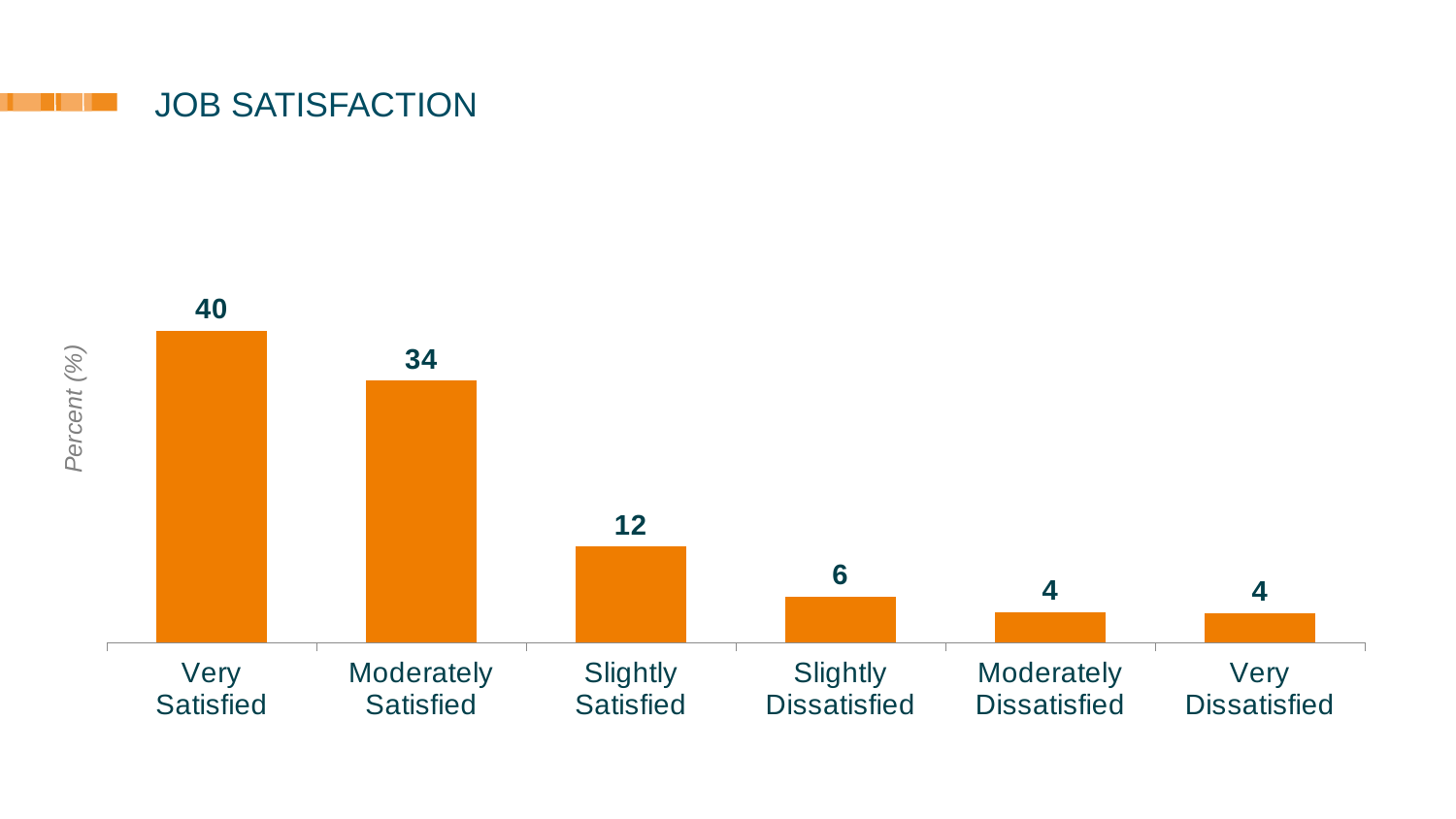
Do the values rise or fall from left to right along the x axis? Fall What is the value for Slightly Dissatisfied? 6 What kind of chart is shown on the slide? Bar chart What is the difference between the values for Slightly Satisfied and Slightly Dissatisfied? 6 How many categories are shown on the x axis? 6 What is the title of the chart? JOB SATISFACTION Which is larger, the value for Slightly Satisfied or the value for Moderately Dissatisfied? Slightly Satisfied What is the difference between the values for Very Satisfied and Moderately Satisfied? 6 What is the label on the vertical axis? Percent (%) What is the value for Moderately Satisfied? 34 Which category has the highest value? Very Satisfied What is the value for Very Satisfied? 40